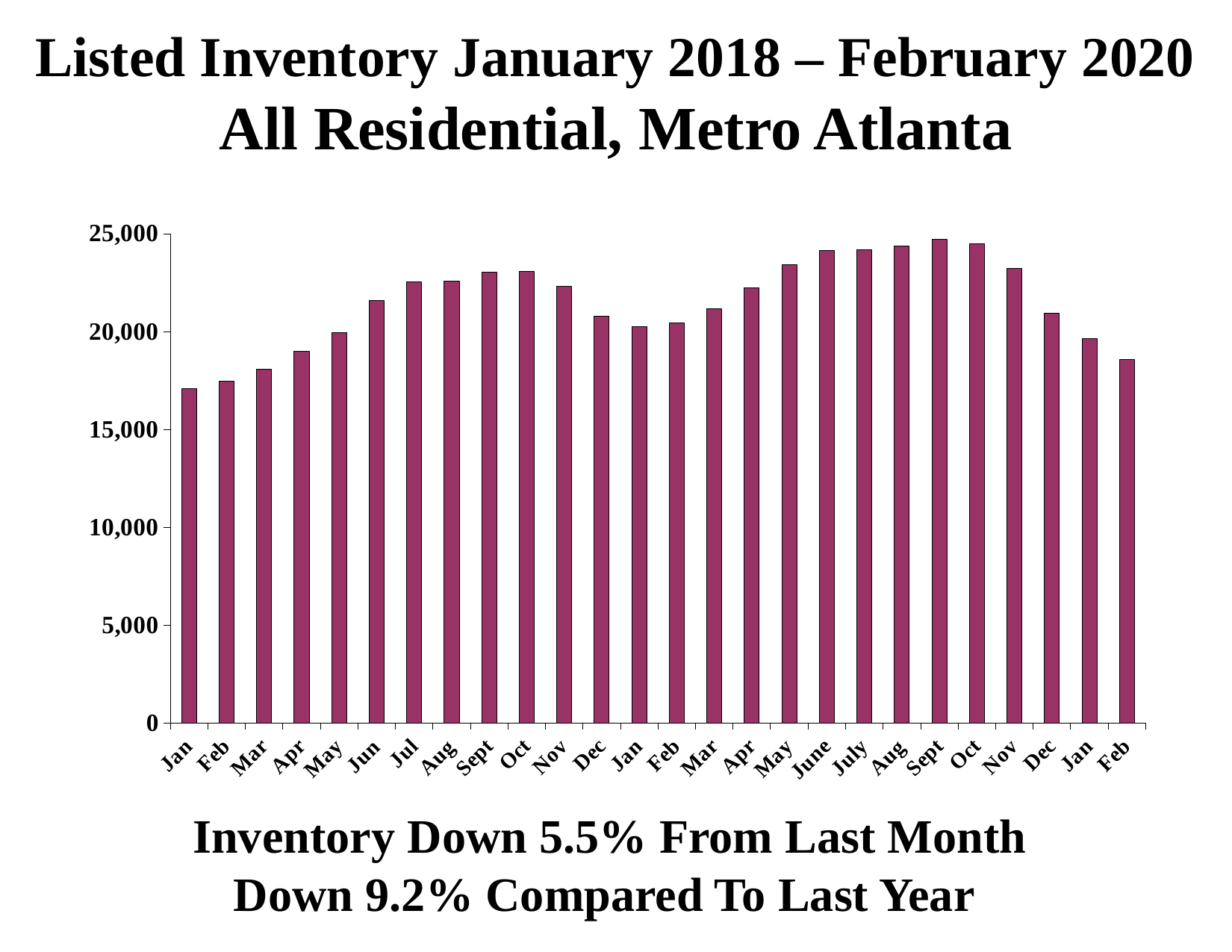
Is the value for the second Sept bar (September 2019) greater or less than 20,000? greater What is the title of the chart on the slide? Listed Inventory January 2018 – February 2020 All Residential, Metro Atlanta Which is larger, the listed inventory for the second Sept bar (September 2019) or the first Jan bar (January 2018)? Sept (2019) Do the values rise or fall from the first Jan bar through the first Sept bar (January to September 2018)? rise Is the value for the last bar (February 2020) greater or less than 20,000? less Do the values rise or fall from the second Oct bar (October 2019) through the final Feb bar (February 2020)? fall Which month has the lowest listed inventory in the chart? Jan (2018, the first bar) How many bars (months) are plotted in the chart? 26 Is the value for the first Jan bar (January 2018) greater or less than 20,000? less What kind of chart is shown on the slide? bar chart